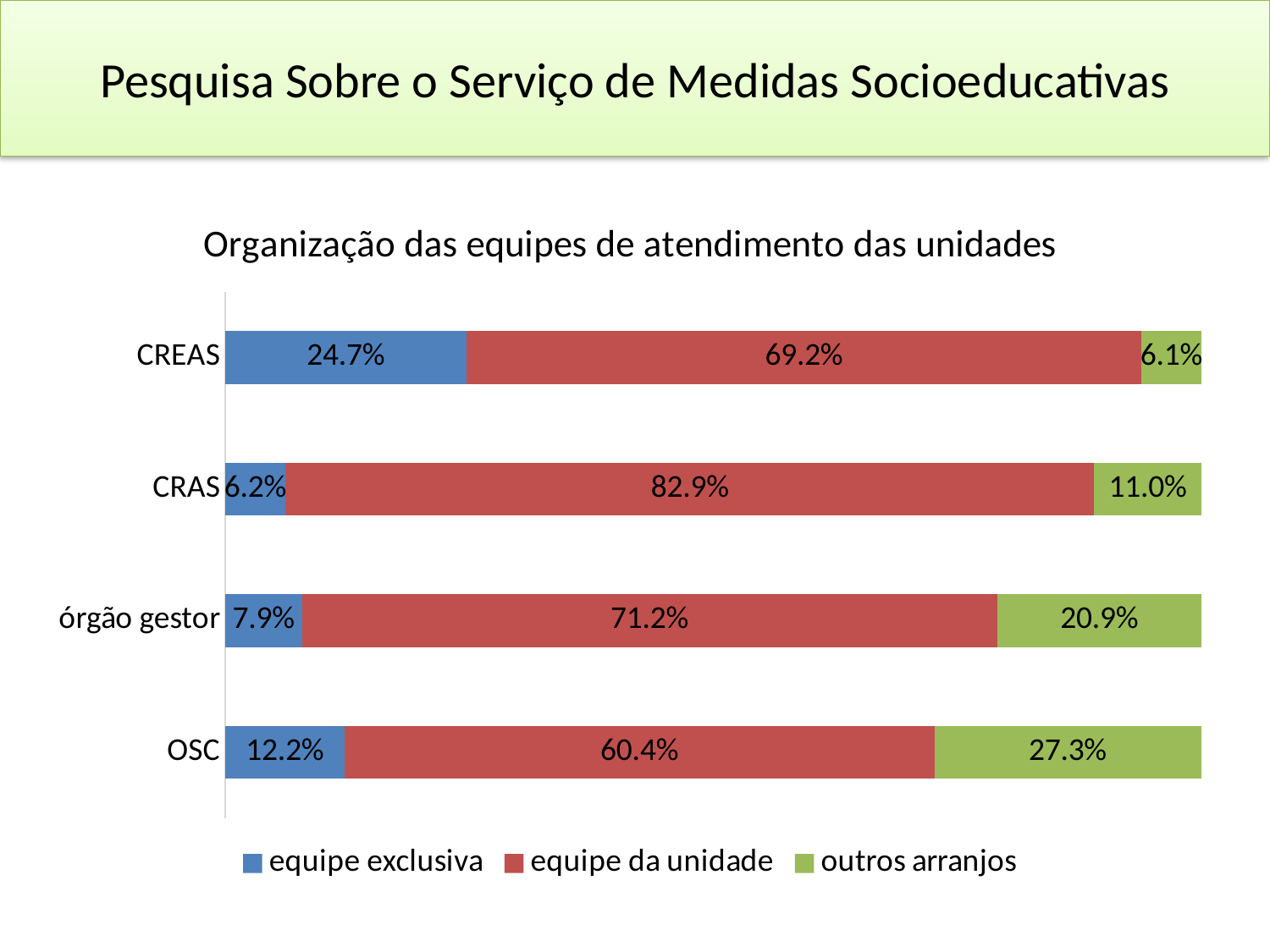
How many series does the legend list? 3 What is the value for 'equipe da unidade' in the CRAS category? 82.9% What is the value for 'outros arranjos' in the OSC category? 27.3% What is the title of the chart? Organização das equipes de atendimento das unidades What is the value for 'equipe exclusiva' in the CREAS category? 24.7% What is the difference between the 'equipe da unidade' values for CRAS and OSC? 22.5% What is the value for 'equipe exclusiva' in the 'órgão gestor' category? 7.9% Which is larger: 'outros arranjos' for 'órgão gestor' or for CRAS? órgão gestor Which category has the lowest value for 'outros arranjos'? CREAS How many categories are shown on the chart? 4 What kind of chart is shown on the slide? Stacked bar chart Which category has the highest value for 'equipe da unidade'? CRAS